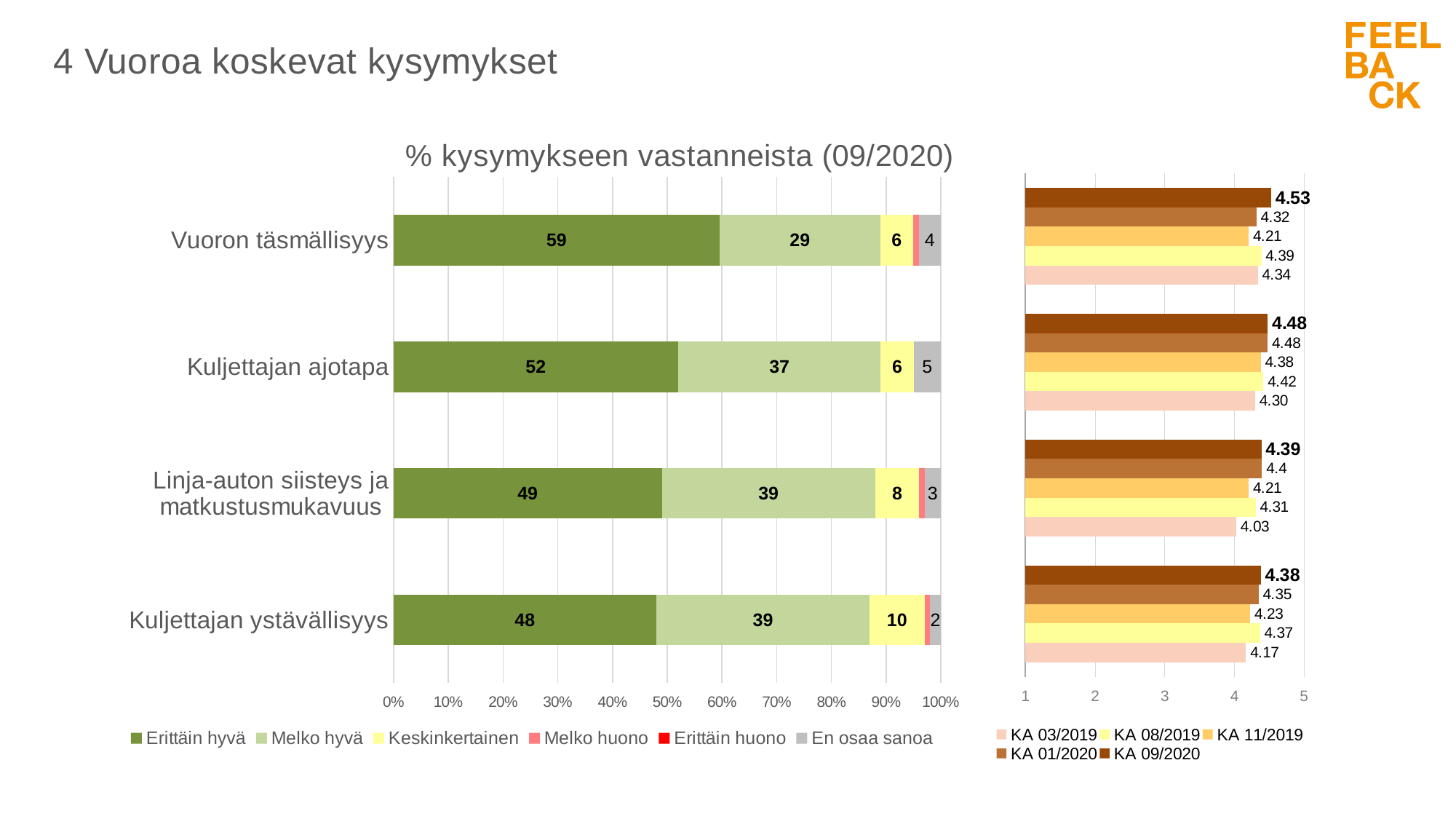
In the chart titled '% kysymykseen vastanneista (09/2020)', which category has the highest 'Erittäin hyvä' value? Vuoron täsmällisyys In the chart titled '% kysymykseen vastanneista (09/2020)', how many categories are shown? 4 In the chart on the right side of the slide, what is the 'KA 09/2020' value for the top group of bars? 4.53 What kind of chart is the chart titled '% kysymykseen vastanneista (09/2020)'? Stacked bar chart In the chart titled '% kysymykseen vastanneista (09/2020)', how many series does the legend list? 6 In the chart titled '% kysymykseen vastanneista (09/2020)', what is the 'Melko hyvä' value for 'Kuljettajan ajotapa'? 37 In the chart on the right side of the slide, in the top group of bars, which is larger: the 'KA 09/2020' value or the 'KA 01/2020' value? KA 09/2020 In the chart on the right side of the slide, what is the lowest 'KA 03/2019' value shown? 4.03 In the chart titled '% kysymykseen vastanneista (09/2020)', what is the 'Erittäin hyvä' value for 'Vuoron täsmällisyys'? 59 In the chart titled '% kysymykseen vastanneista (09/2020)', what is the difference between the 'Erittäin hyvä' values for 'Vuoron täsmällisyys' and 'Kuljettajan ajotapa'? 7 In the chart on the right side of the slide, how many series does the legend list? 5 In the chart titled '% kysymykseen vastanneista (09/2020)', what is the 'Keskinkertainen' value for 'Kuljettajan ystävällisyys'? 10